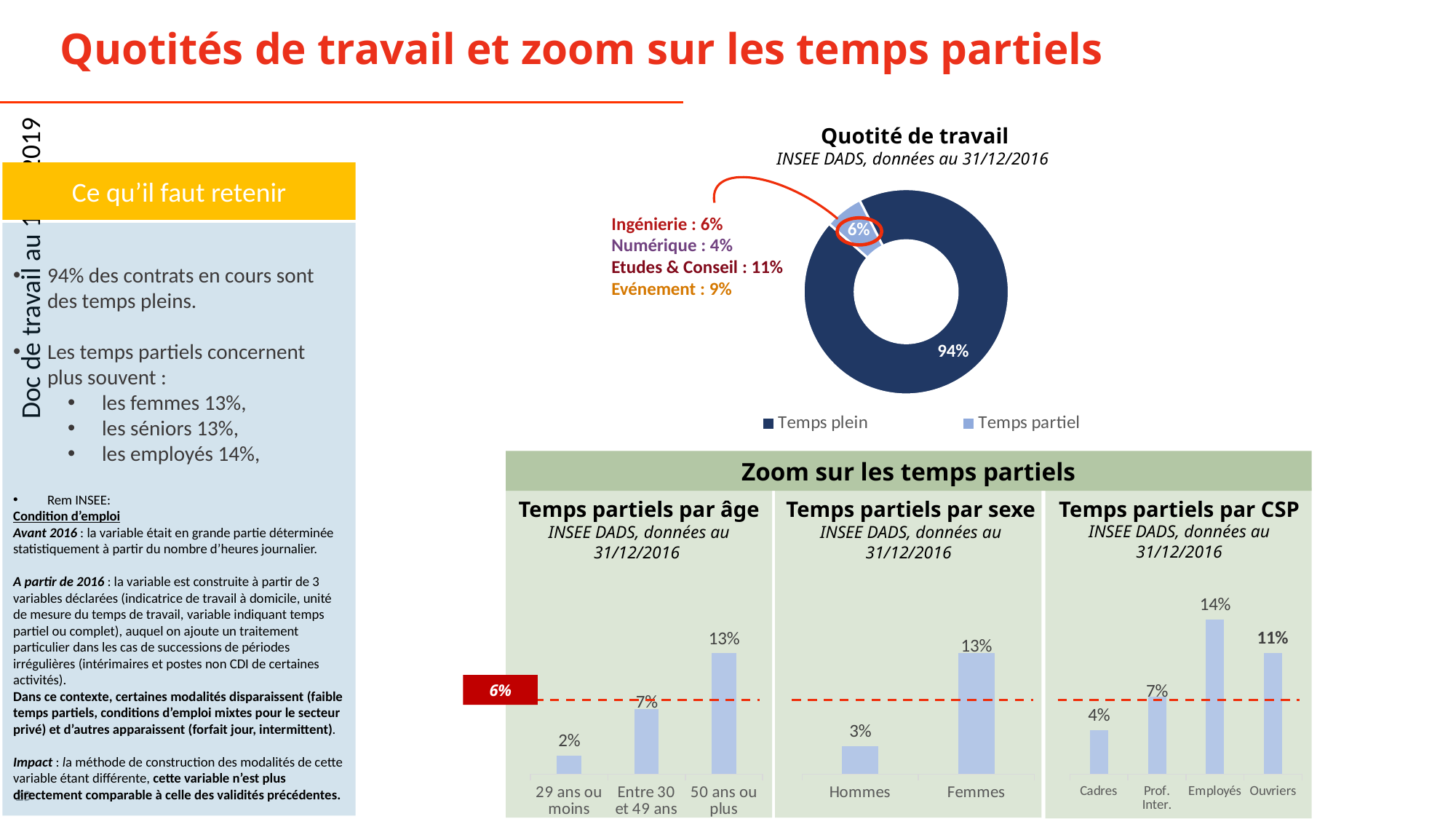
In the 'Temps partiels par âge' chart, do the values rise or fall from left to right? Rise In the 'Temps partiels par sexe' chart, which is larger, Hommes or Femmes? Femmes In the 'Temps partiels par âge' chart, which age group has the lowest value? 29 ans ou moins What kind of chart is 'Quotité de travail'? Donut (pie) chart How many series does the legend of the 'Quotité de travail' chart list? 2 In the 'Quotité de travail' chart, what share is Temps partiel? 6% In the 'Temps partiels par CSP' chart, what is the value for Ouvriers? 11% In the 'Temps partiels par CSP' chart, which category has the highest value? Employés In the 'Temps partiels par sexe' chart, what is the difference between Femmes and Hommes? 10% How many categories are shown in the 'Temps partiels par CSP' chart? 4 In the 'Quotité de travail' chart, what share is Temps plein? 94% In the 'Temps partiels par âge' chart, what is the value for '50 ans ou plus'? 13%